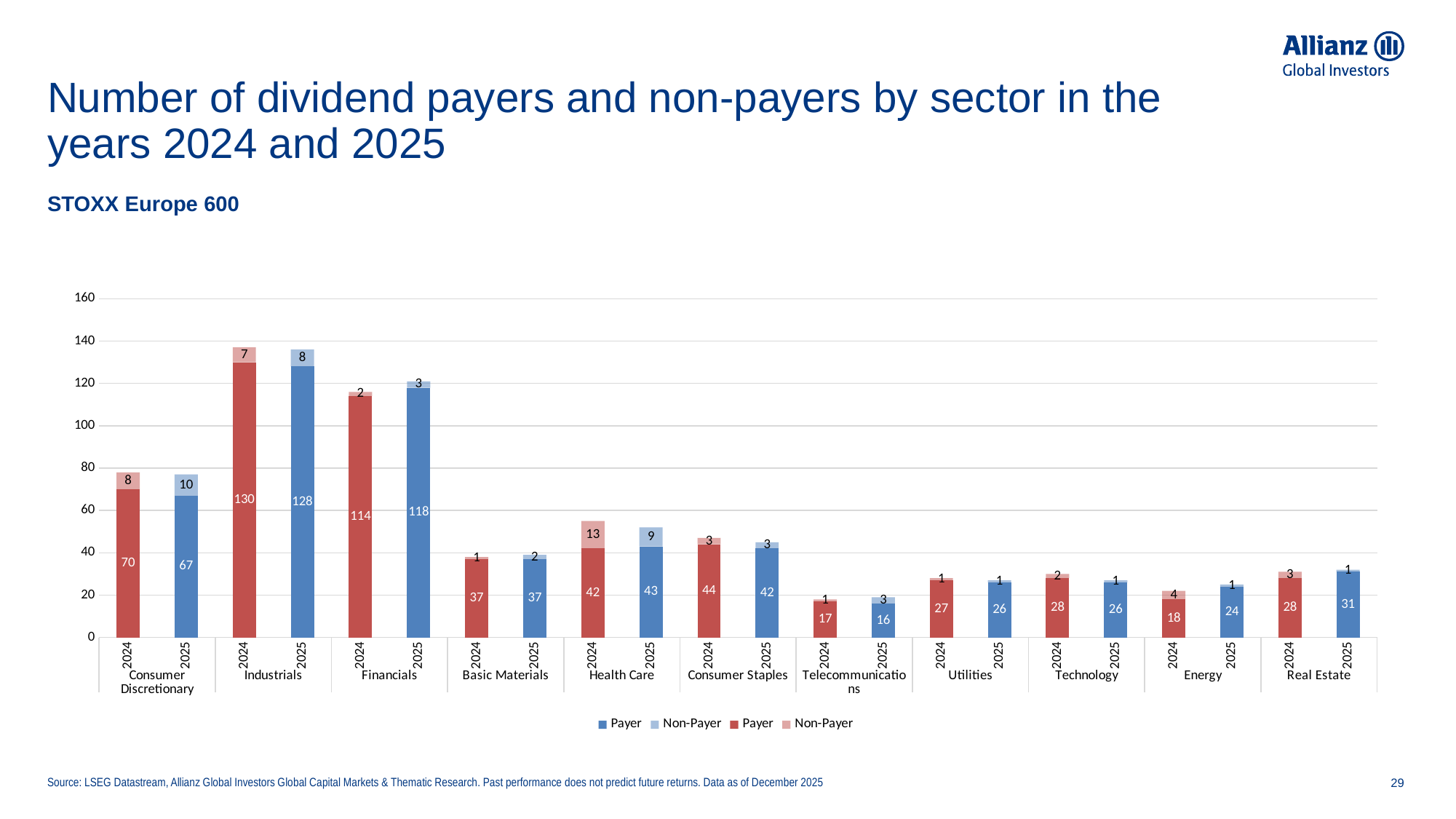
What type of chart is shown on the slide? Stacked bar chart How many entries does the chart legend list? 4 Which index does the chart cover, according to the subtitle? STOXX Europe 600 By how much did the number of payers in Financials increase from 2024 to 2025? 4 Which sector had the fewest dividend payers in 2024? Telecommunications How many non-payers were there in the Health Care sector in 2024? 13 How many dividend payers were there in the Industrials sector in 2024? 130 In the Energy sector, were there more dividend payers in 2024 or in 2025? 2025 What is the total number of companies (payers plus non-payers) in Consumer Discretionary in 2024? 78 How many sectors are shown on the x axis of the chart? 11 Which sector had the highest number of dividend payers in 2025? Industrials Is the total height of the Industrials 2024 bar greater or less than 120? greater